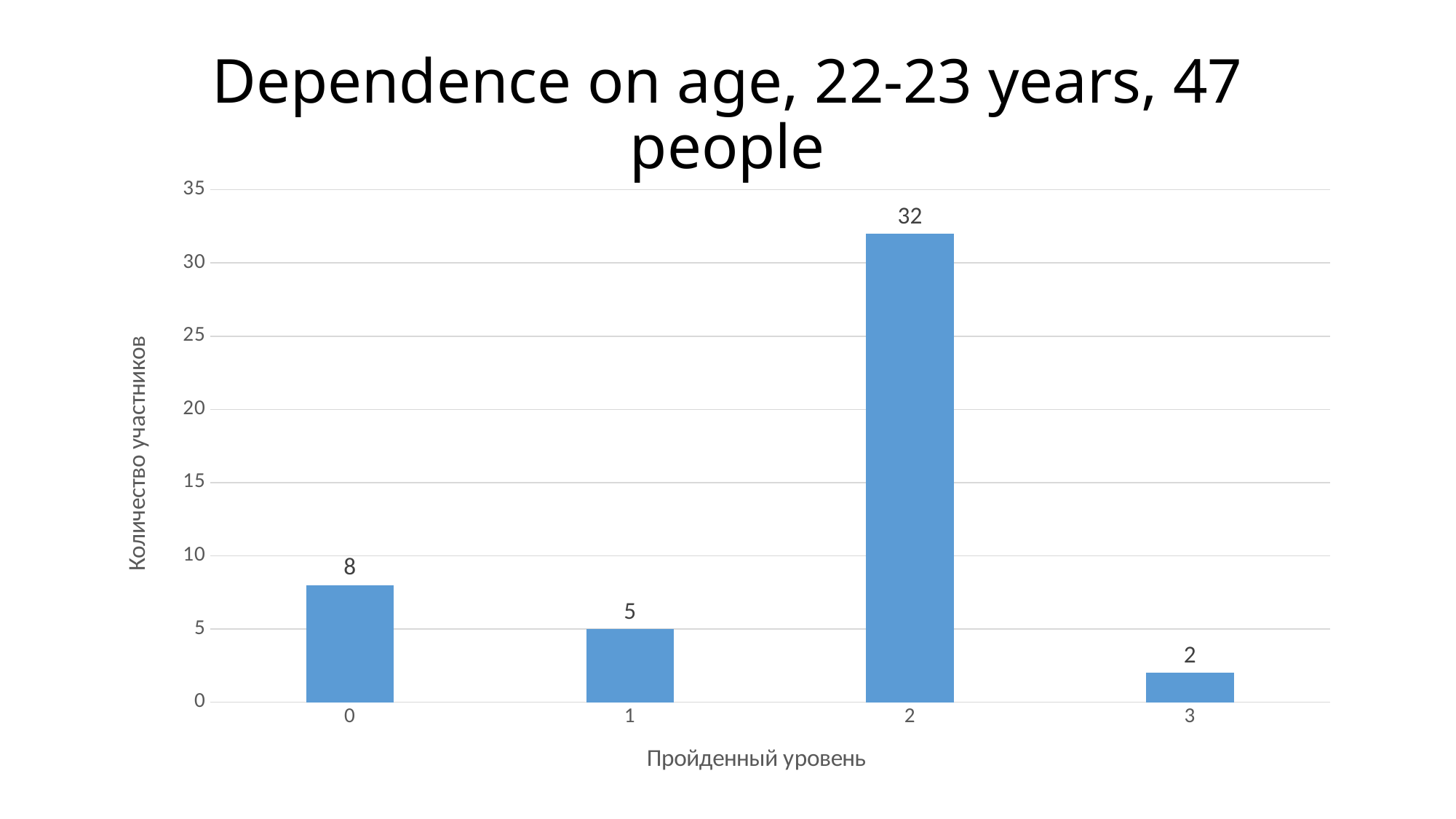
Which level has the highest number of participants? 2 Is the value for level 2 greater or less than 30? greater What is the value for level 3? 2 What is the difference between the values for level 2 and level 0? 24 What is the title of the chart? Dependence on age, 22-23 years, 47 people What is the value for level 2? 32 What is the label of the x axis? Пройденный уровень What kind of chart is shown on the slide? bar chart Which level has the lowest number of participants? 3 How many categories are shown on the x axis? 4 Which is larger, the value for level 0 or the value for level 1? level 0 What is the value for level 0? 8